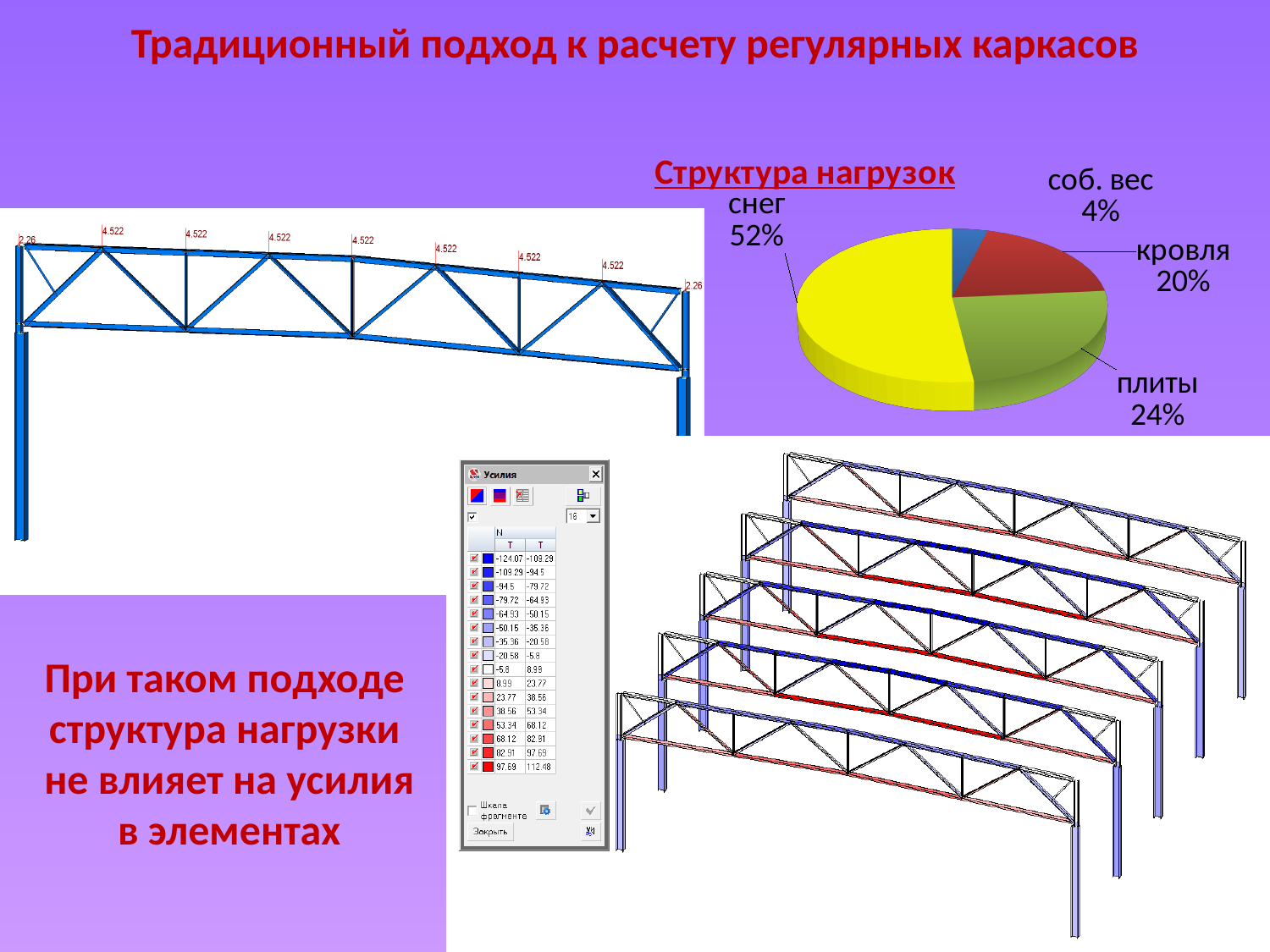
What colour is the 'снег' slice in the pie chart 'Структура нагрузок'? yellow What type of chart is 'Структура нагрузок'? pie chart How many slices does the pie chart 'Структура нагрузок' have? 4 Which category has the smallest slice in the pie chart 'Структура нагрузок'? соб. вес What share of the pie chart 'Структура нагрузок' is 'снег'? 52% In the pie chart 'Структура нагрузок', what is the difference between the shares of 'снег' and 'плиты'? 28% In the pie chart 'Структура нагрузок', what is the difference between the shares of 'плиты' and 'кровля'? 4% What share of the pie chart 'Структура нагрузок' is 'плиты'? 24% What share of the pie chart 'Структура нагрузок' is 'кровля'? 20% In the pie chart 'Структура нагрузок', which is larger: 'кровля' or 'плиты'? плиты Which category has the largest slice in the pie chart 'Структура нагрузок'? снег What share of the pie chart 'Структура нагрузок' is 'соб. вес'? 4%